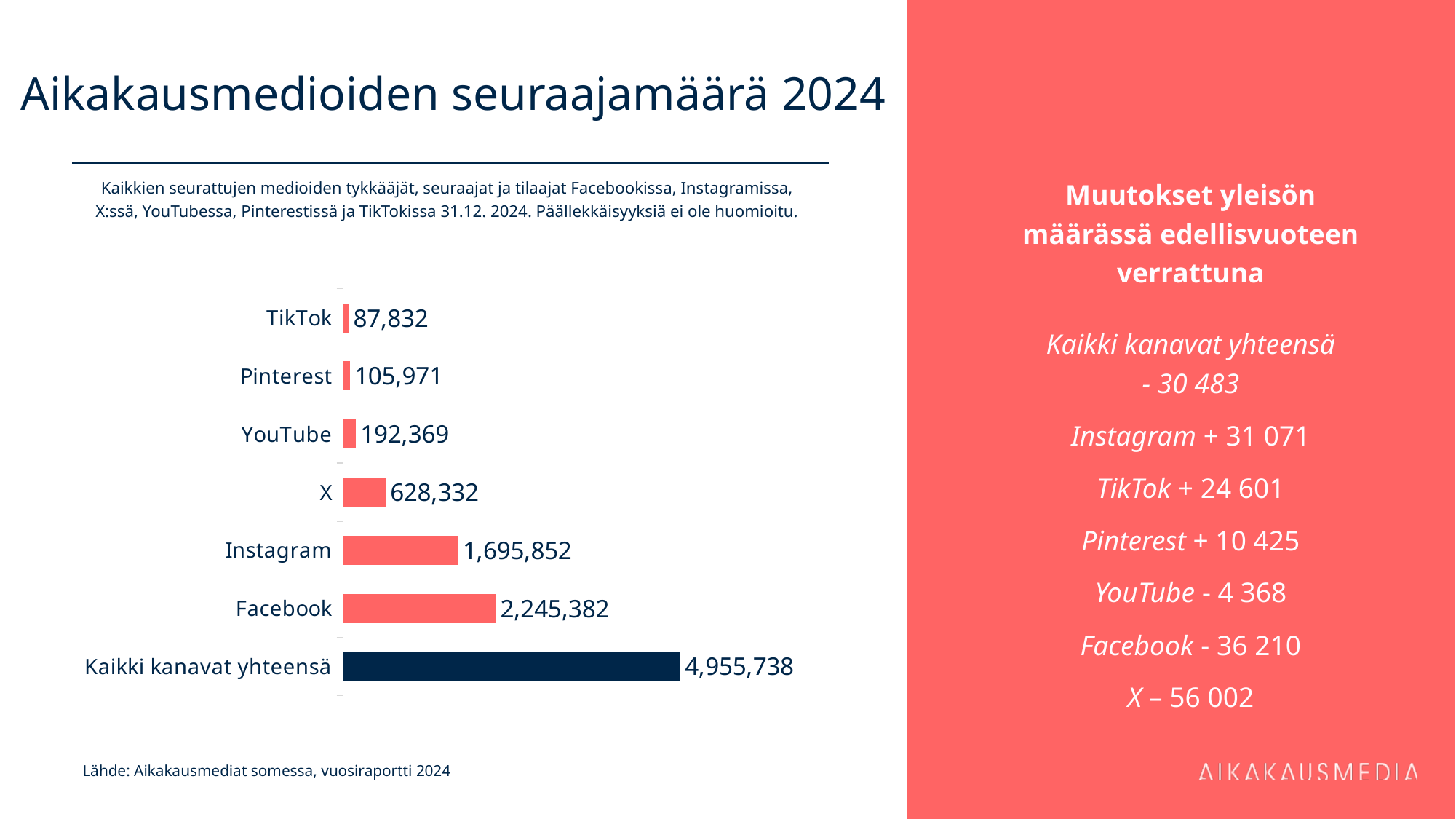
What is the difference between the values for Facebook and Instagram? 549,530 Which bar is shown in a different (dark navy) colour from the others? Kaikki kanavat yhteensä What kind of chart is shown on the slide? Bar chart Which individual channel (excluding the total) has the highest value? Facebook How many categories are shown in the chart? 7 What is the value for Kaikki kanavat yhteensä? 4,955,738 Which is larger, the value for X or the value for YouTube? X What is the value for TikTok? 87,832 What is the value for Facebook? 2,245,382 What is the difference between the values for Pinterest and TikTok? 18,139 What is the value for Instagram? 1,695,852 Which category has the lowest value? TikTok